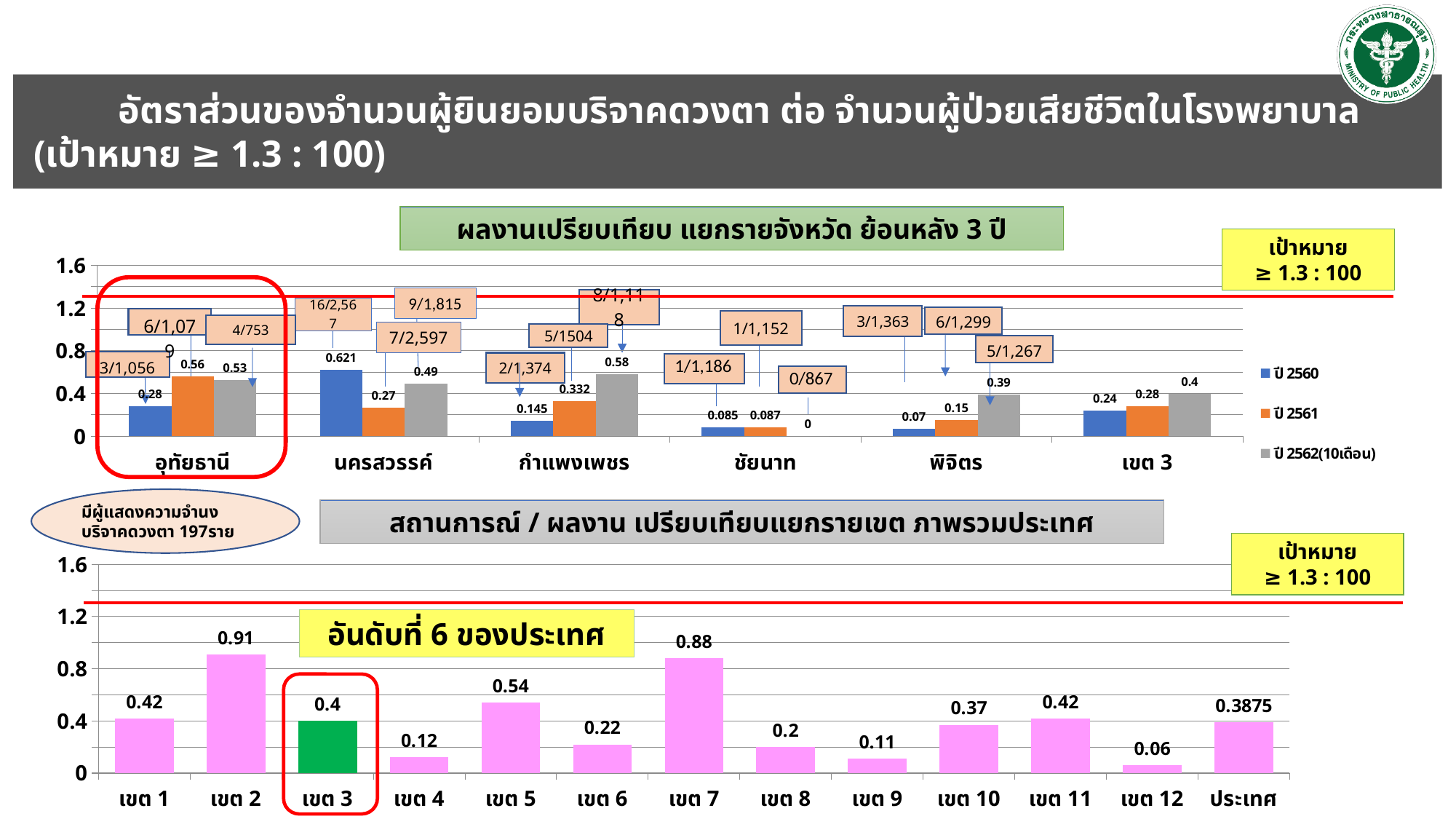
What kind of chart is the top chart? Bar chart In the bottom chart, how many bars are plotted? 13 In the bottom chart, what is the value for ประเทศ? 0.3875 In the bottom chart, which category has the lowest value? เขต 12 In the bottom chart, what is the difference between the values for เขต 7 and เขต 3? 0.48 In the top chart, for อุทัยธานี, which is larger: the value for ปี 2560 or ปี 2561? ปี 2561 In the top chart, what is the value for นครสวรรค์ in ปี 2560? 0.621 In the bottom chart, which category has the highest value? เขต 2 In the top chart, which province has the highest value for ปี 2562(10เดือน)? กำแพงเพชร In the bottom chart (สถานการณ์ / ผลงาน เปรียบเทียบแยกรายเขต ภาพรวมประเทศ), what is the value for เขต 5? 0.54 In the top chart, do the values for พิจิตร rise or fall from ปี 2560 to ปี 2562(10เดือน)? Rise In the top chart (ผลงานเปรียบเทียบ แยกรายจังหวัด ย้อนหลัง 3 ปี), how many series does the legend list? 3